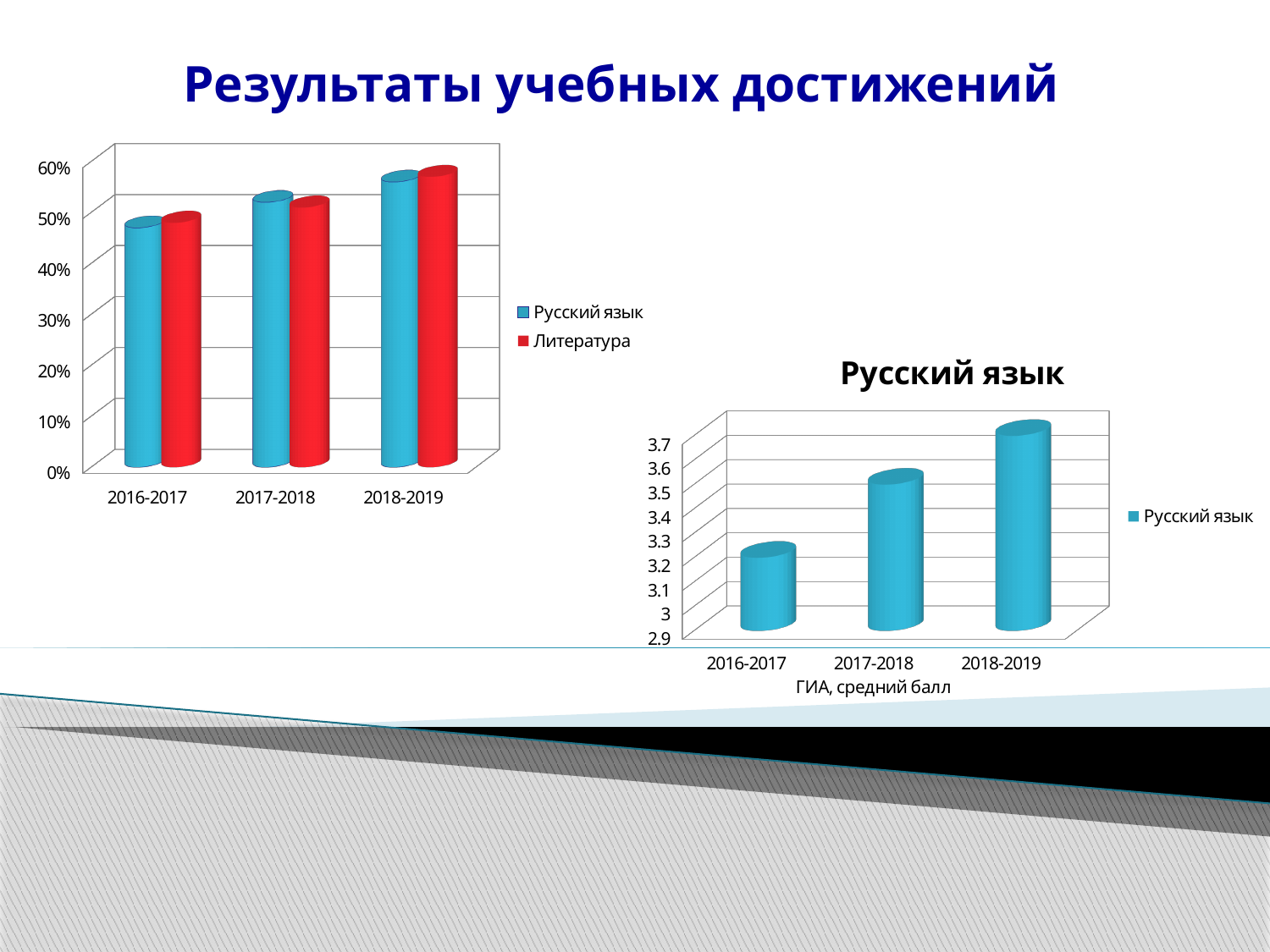
On the left chart, how many categories are shown on the x axis? 3 On the chart titled Русский язык, is the value for 2018-2019 greater or less than 3.6? greater On the chart titled Русский язык, in which year is the value highest? 2018-2019 On the left chart, is the value for Литература in 2018-2019 greater or less than 50%? greater On the left chart, what kind of chart is shown? bar chart On the chart titled Русский язык, is the value for 2016-2017 greater or less than 3.3? less On the left chart, how many series does the legend list? 2 On the left chart, do the values for Русский язык rise or fall from 2016-2017 to 2018-2019? rise On the chart titled Русский язык, what is the x-axis title? ГИА, средний балл On the left chart, in which year is the value for Русский язык highest? 2018-2019 On the left chart, in which year is the value for Литература lowest? 2016-2017